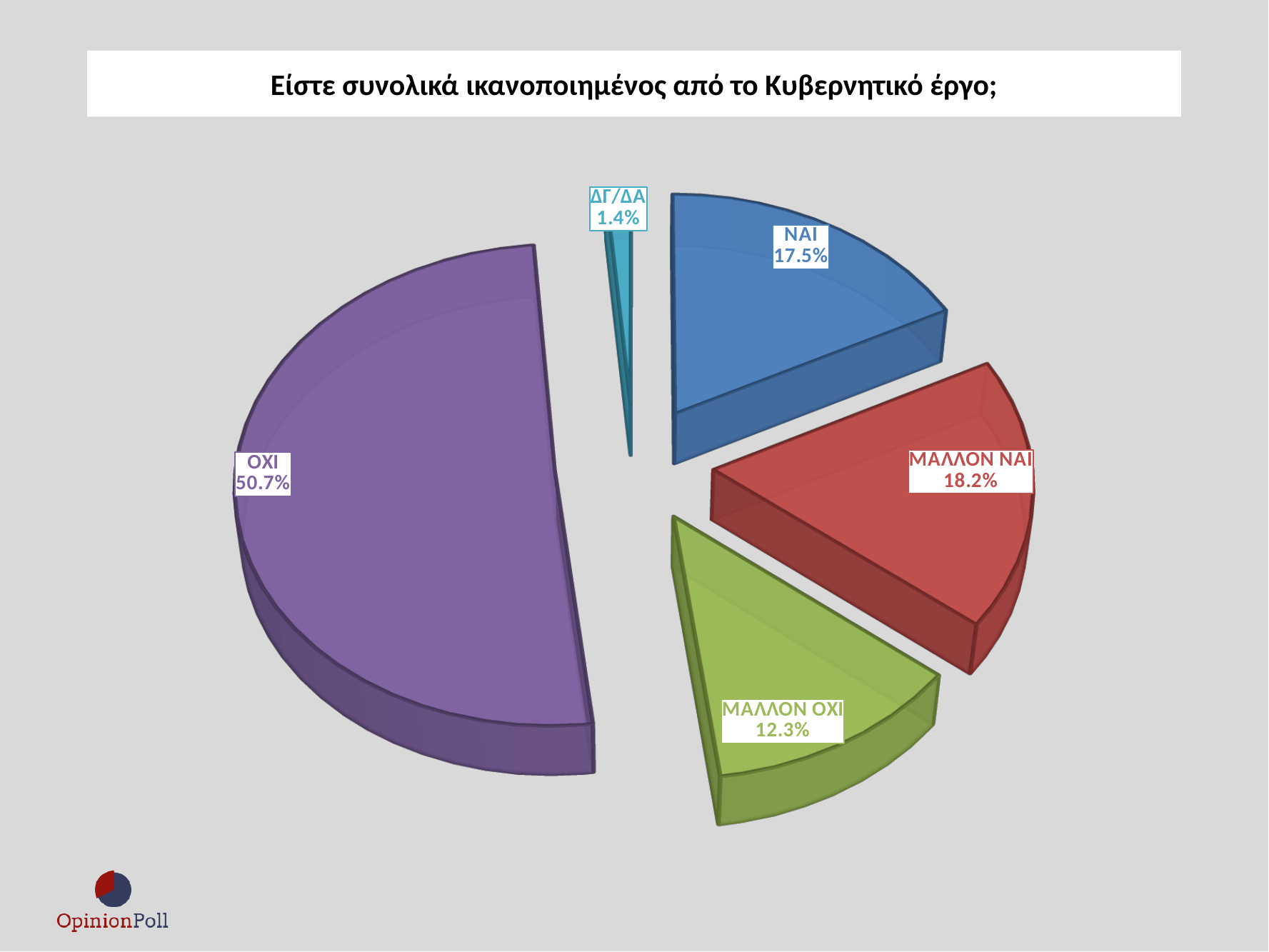
Which is larger, the share for ΜΑΛΛΟΝ ΝΑΙ or the share for ΜΑΛΛΟΝ ΟΧΙ? ΜΑΛΛΟΝ ΝΑΙ What percentage of respondents answered ΝΑΙ? 17.5% What percentage of respondents answered ΟΧΙ? 50.7% What colour is the ΟΧΙ slice? Purple Which response has the largest share of the pie? ΟΧΙ What percentage of respondents answered ΜΑΛΛΟΝ ΟΧΙ? 12.3% Which response has the smallest share of the pie? ΔΓ/ΔΑ How many slices does the pie chart have? 5 What kind of chart is shown on the slide? Pie chart What percentage of respondents answered ΔΓ/ΔΑ? 1.4% What percentage of respondents answered ΜΑΛΛΟΝ ΝΑΙ? 18.2% What is the difference in percentage points between ΟΧΙ and ΝΑΙ? 33.2